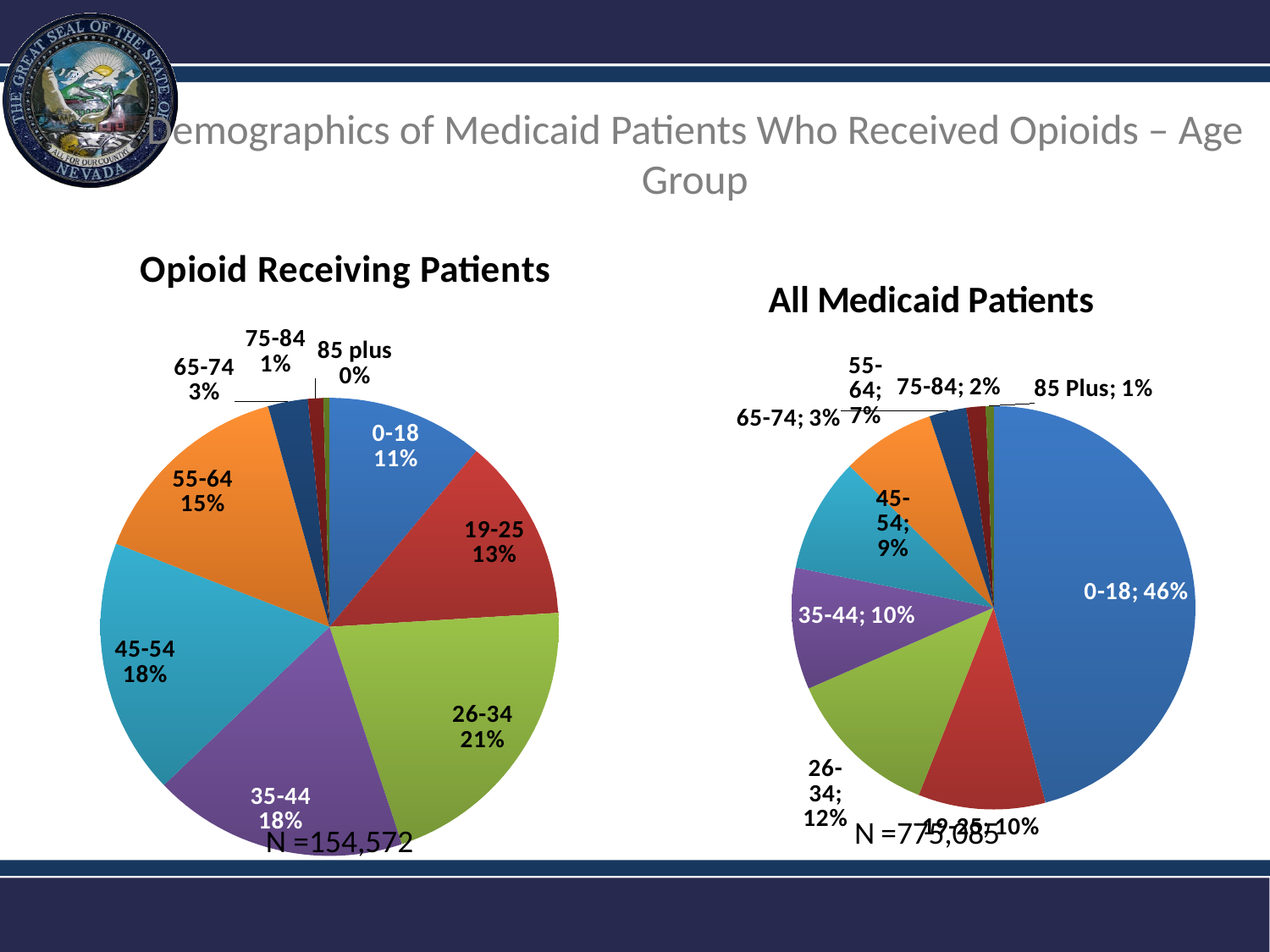
What is the N value shown under the Opioid Receiving Patients chart? N =154,572 What type of chart is used for All Medicaid Patients? Pie chart In the Opioid Receiving Patients chart, what share of patients are in the 26-34 age group? 21% In the All Medicaid Patients chart, which age group has the largest share? 0-18 In the Opioid Receiving Patients chart, which age group has the largest share? 26-34 How many age groups are shown in the Opioid Receiving Patients chart? 9 Which is larger in the Opioid Receiving Patients chart: the 55-64 share or the 19-25 share? 55-64 Which chart shows a larger share for the 0-18 age group: Opioid Receiving Patients or All Medicaid Patients? All Medicaid Patients In the Opioid Receiving Patients chart, what is the difference between the 26-34 share and the 0-18 share? 10 percentage points In the All Medicaid Patients chart, what share of patients are in the 0-18 age group? 46% In the Opioid Receiving Patients chart, which age group has the smallest share? 85 plus In the All Medicaid Patients chart, what is the difference between the 0-18 share and the 26-34 share? 34 percentage points